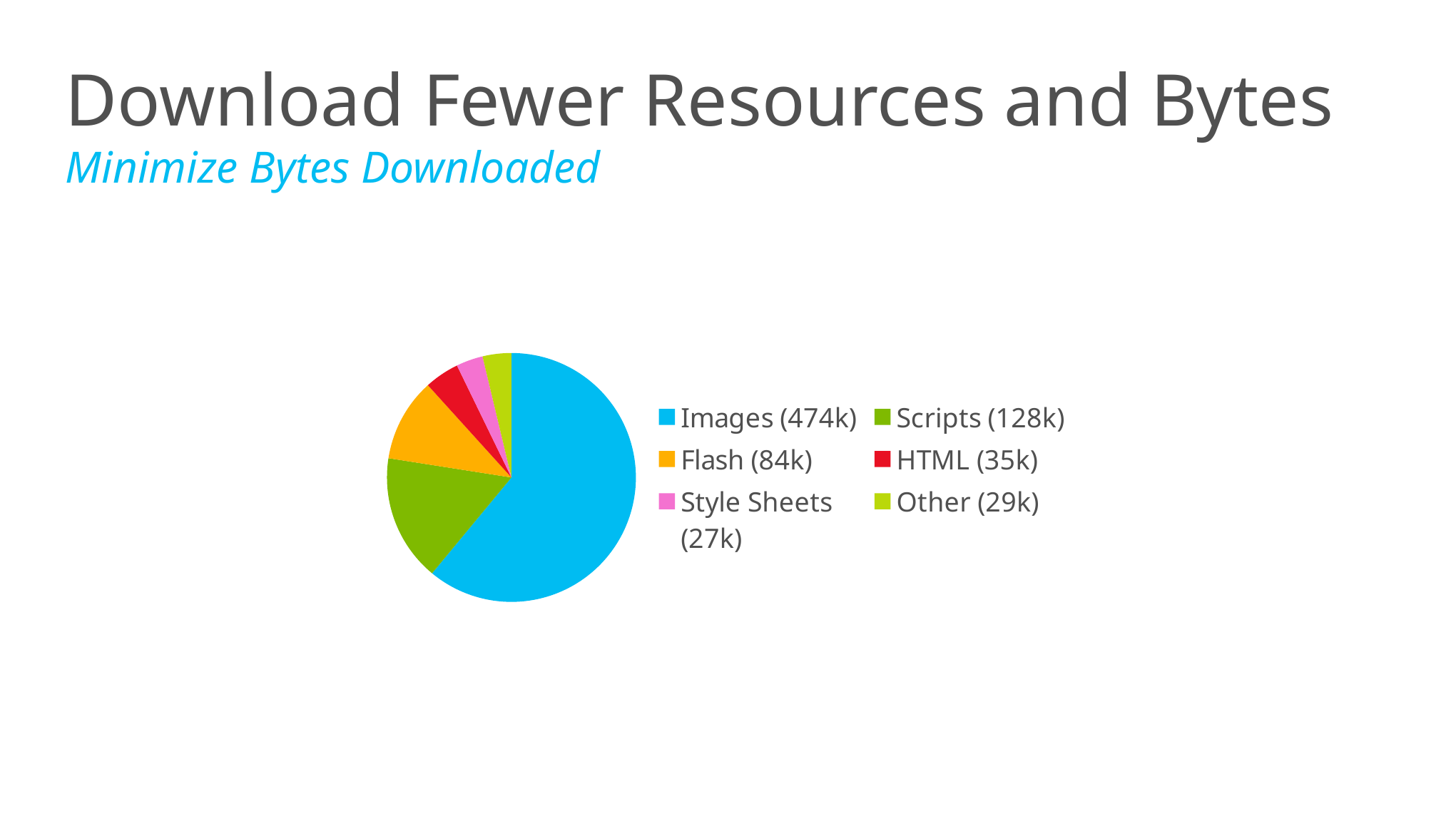
What is the difference between the Images value and the Scripts value? 346k What value is shown for Style Sheets in the pie chart legend? 27k What is the difference between the Flash value and the HTML value? 49k What kind of chart is shown on the slide? pie chart Which category has the smallest value in the pie chart? Style Sheets What value is shown for Flash in the pie chart legend? 84k What value is shown for Scripts in the pie chart legend? 128k Which is larger, the value for HTML or the value for Other? HTML How many categories does the pie chart show? 6 What value is shown for Images in the pie chart legend? 474k What colour is the Flash slice in the pie chart? orange Which category has the largest slice of the pie chart? Images